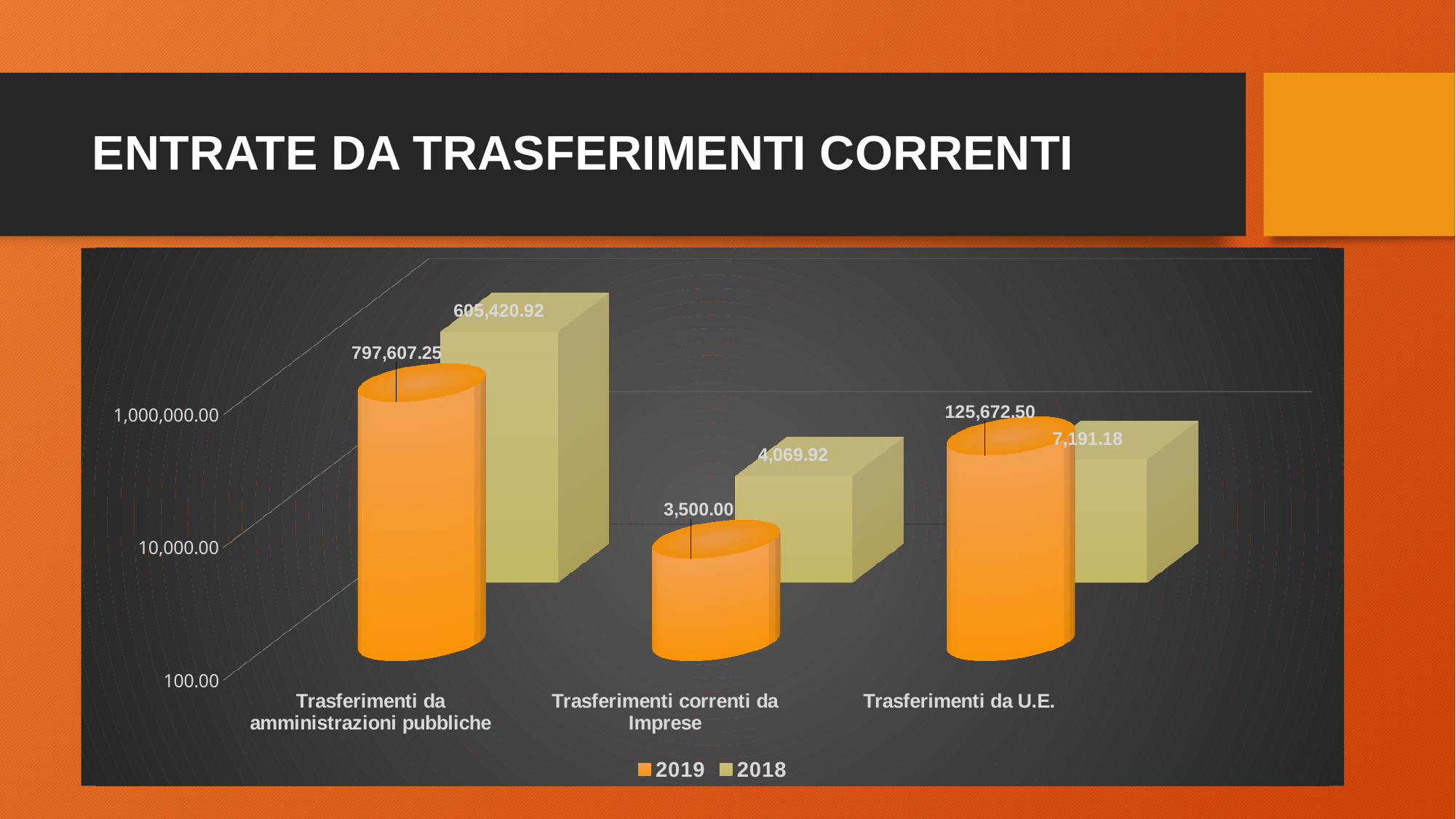
How many categories are shown on the x axis? 3 What is the difference between the 2018 and 2019 values for Trasferimenti correnti da Imprese? 569.92 What is the 2018 value for Trasferimenti correnti da Imprese? 4,069.92 What kind of chart is shown on the slide? Bar chart What is the 2019 value for Trasferimenti da U.E.? 125,672.50 What is the 2018 value for Trasferimenti da U.E.? 7,191.18 What is the 2019 value for Trasferimenti da amministrazioni pubbliche? 797,607.25 How many series does the legend list? 2 For Trasferimenti correnti da Imprese, which year has the larger value, 2019 or 2018? 2018 Which category has the lowest 2018 value? Trasferimenti correnti da Imprese What is the difference between the 2019 and 2018 values for Trasferimenti da U.E.? 118,481.32 Which category has the highest 2019 value? Trasferimenti da amministrazioni pubbliche